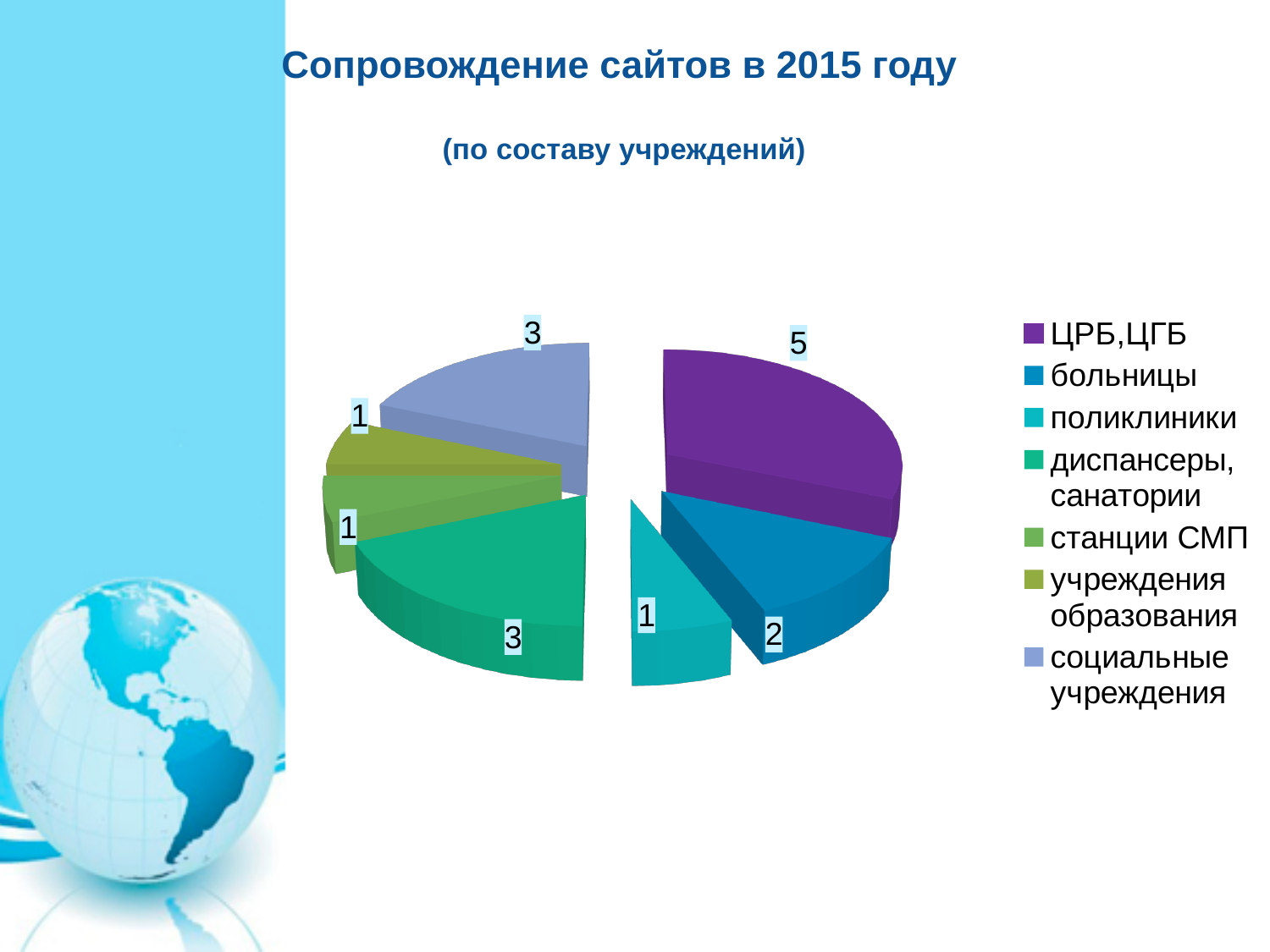
Which category has the largest slice of the pie? ЦРБ,ЦГБ What is the title of the chart on the slide? Сопровождение сайтов в 2015 году (по составу учреждений) What kind of chart is shown on the slide? pie chart What is the total of all the slices in the pie chart? 16 How many categories have a value of 1? 3 Which is larger, the value for больницы or the value for поликлиники? больницы What is the difference between the values for ЦРБ,ЦГБ and больницы? 3 How many categories does the legend of the pie chart list? 7 What is the value for социальные учреждения? 3 What is the value for ЦРБ,ЦГБ? 5 What is the value for больницы? 2 What is the value for диспансеры, санатории? 3